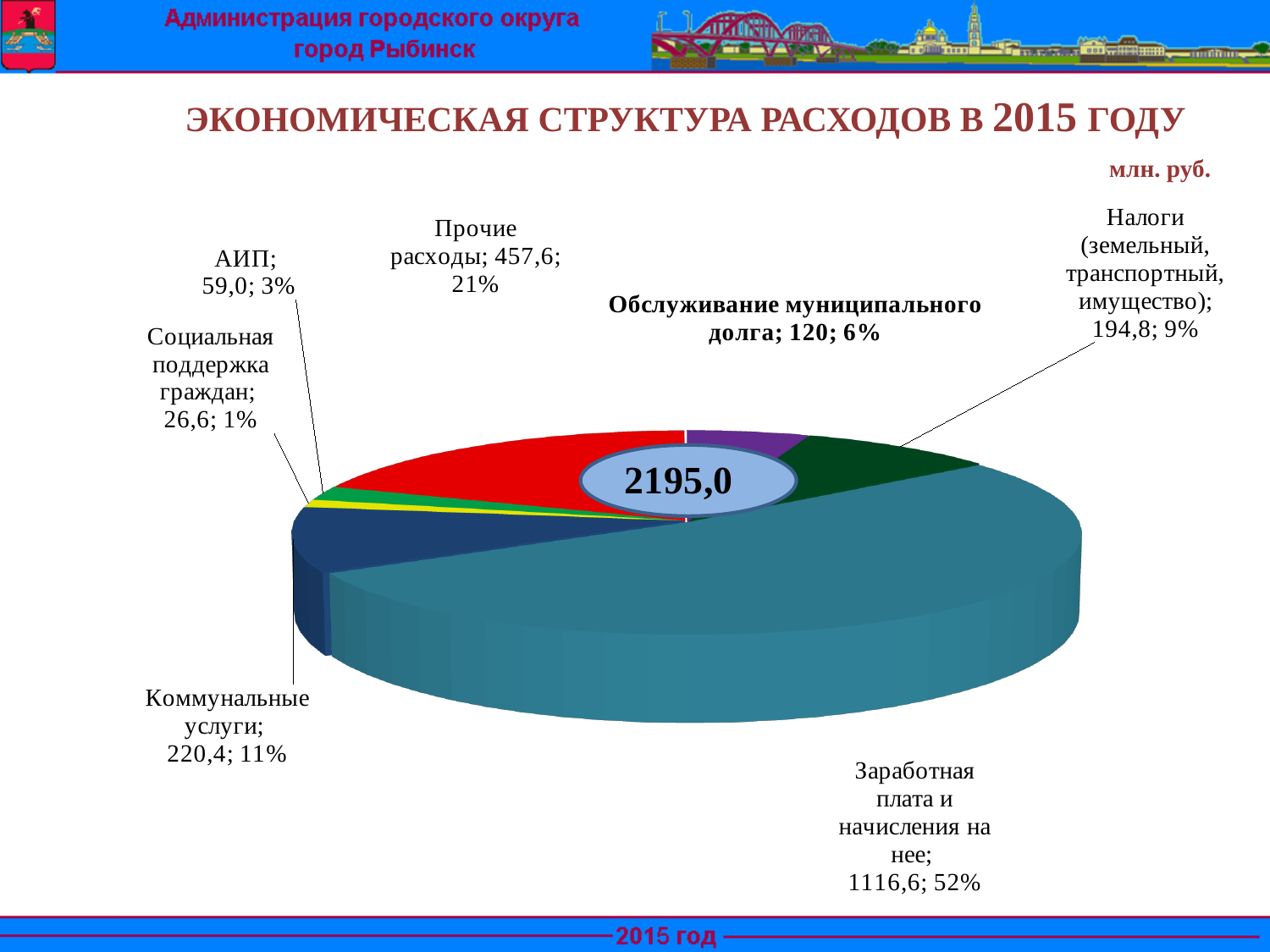
What share of the pie does "Обслуживание муниципального долга" represent? 6% What kind of chart is shown on the slide? Pie chart What total value is shown in the centre of the pie chart? 2195,0 Which is larger: the value for "Налоги (земельный, транспортный, имущество)" or for "Обслуживание муниципального долга"? Налоги (земельный, транспортный, имущество) What is the value for "Коммунальные услуги"? 220,4 What unit is indicated for the values on the chart? млн. руб. Which category has the largest value? Заработная плата и начисления на нее Which category has the smallest value? Социальная поддержка граждан What is the value for "Заработная плата и начисления на нее"? 1116,6 How many categories are shown in the pie chart? 7 What is the difference between the values for "Прочие расходы" and "Коммунальные услуги"? 237,2 What share of the pie does "Прочие расходы" represent? 21%